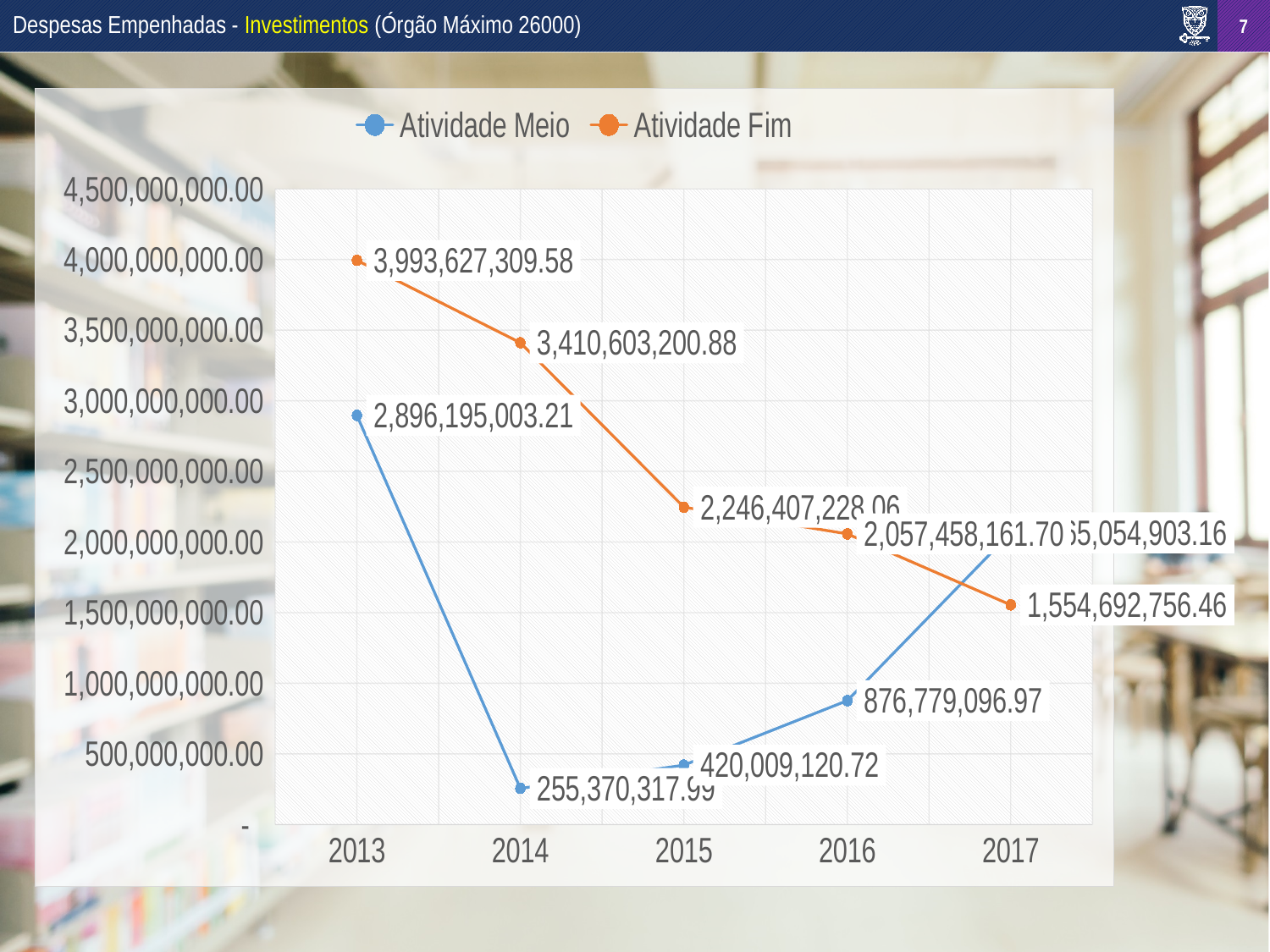
What is the value for Atividade Fim in 2013? 3,993,627,309.58 In which year is Atividade Meio lowest? 2014 What is the value for Atividade Meio in 2016? 876,779,096.97 Does the Atividade Fim series rise or fall from 2013 to 2017? fall How many series does the legend list? 2 What is the value for Atividade Fim in 2014? 3,410,603,200.88 In which year is Atividade Fim highest? 2013 How many years are shown on the x axis? 5 What is the difference between Atividade Fim in 2013 and in 2014? 583,024,108.70 What kind of chart is shown on the slide? line chart What is the value for Atividade Fim in 2017? 1,554,692,756.46 What is the value for Atividade Meio in 2013? 2,896,195,003.21